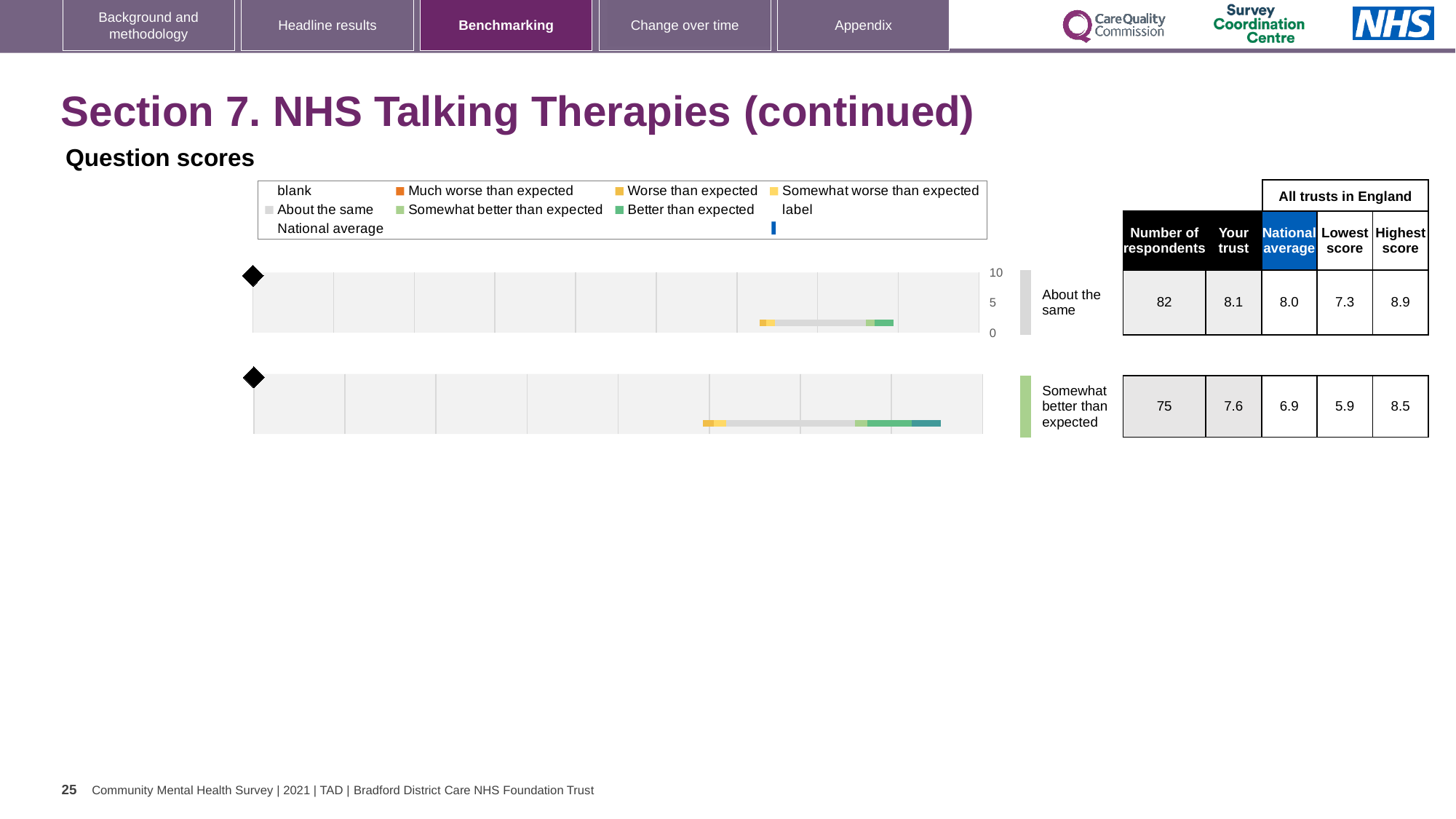
For the top chart, what is the lowest score among all trusts in England? 7.3 What kind of chart is used to show the question scores on this slide? Bar chart Which chart has the higher 'Your trust' score, the top chart or the bottom chart? Top chart For the top chart, what is the difference between the highest and lowest scores among all trusts in England? 1.6 For the top chart, how many respondents are shown in the table? 82 For the bottom chart, what is the difference between the 'Your trust' score and the national average? 0.7 For the bottom chart, how many respondents are shown in the table? 75 How many question score charts are shown on the slide? 2 For the bottom chart, what is the national average score shown in the table? 6.9 For the bottom chart, what is the highest score among all trusts in England? 8.5 For the top chart, what is the 'Your trust' score shown in the table? 8.1 What benchmark category is the bottom chart labelled with? Somewhat better than expected